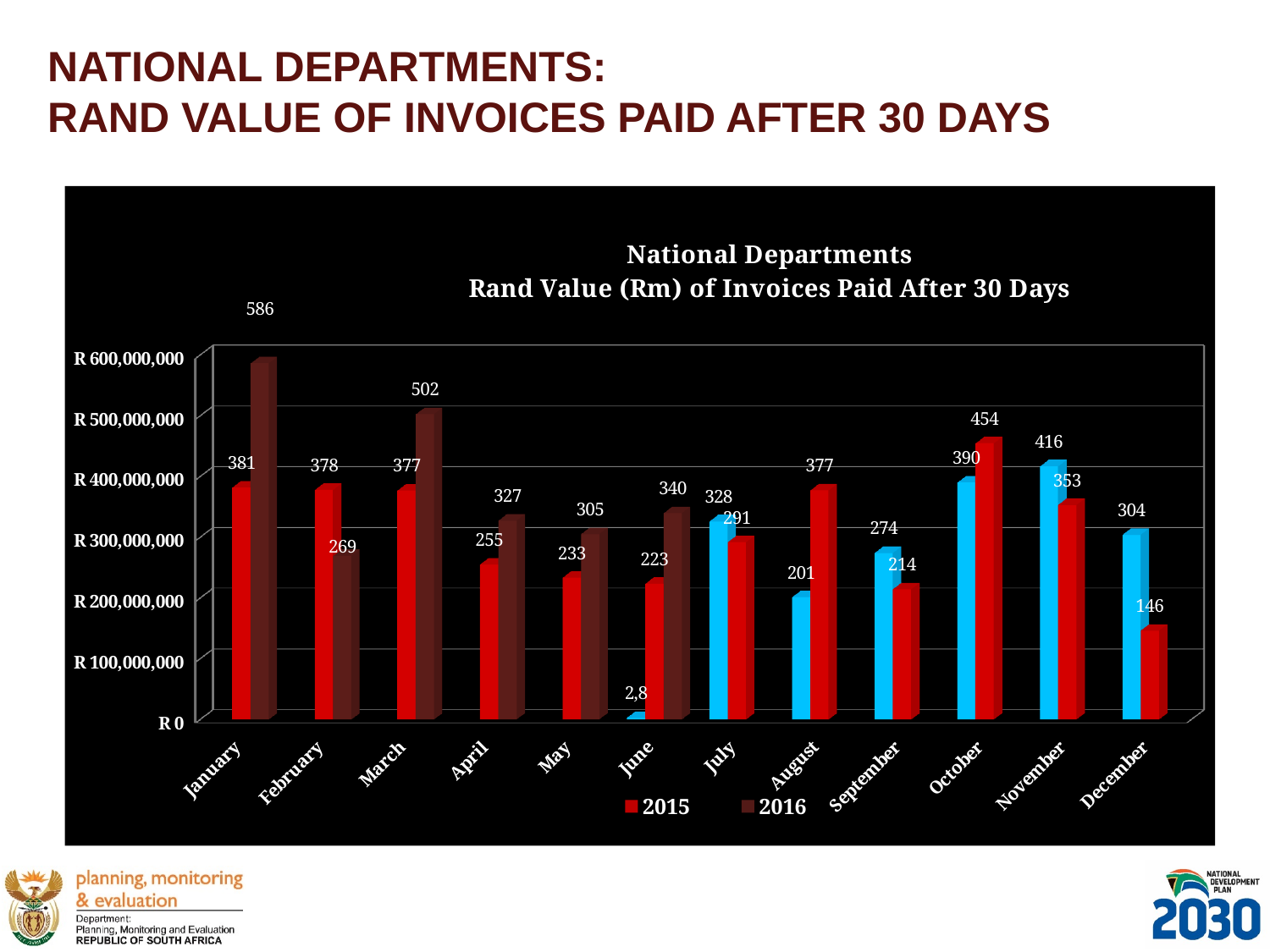
What is the 2016 value for January? 586 Which month has the highest 2016 value? January For February, which series has the larger value, 2015 or 2016? 2015 What is the 2015 value for April? 255 How many series does the legend list? 2 Is the 2015 value for October greater or less than R 400,000,000? greater Do the 2015 values rise or fall from January to June? Fall Which month has the lowest 2015 value? December What is the difference between the 2016 and 2015 values for March? 125 What kind of chart is shown on the slide? Bar chart What is the 2016 value for March? 502 What is the difference between the 2016 and 2015 values for January? 205